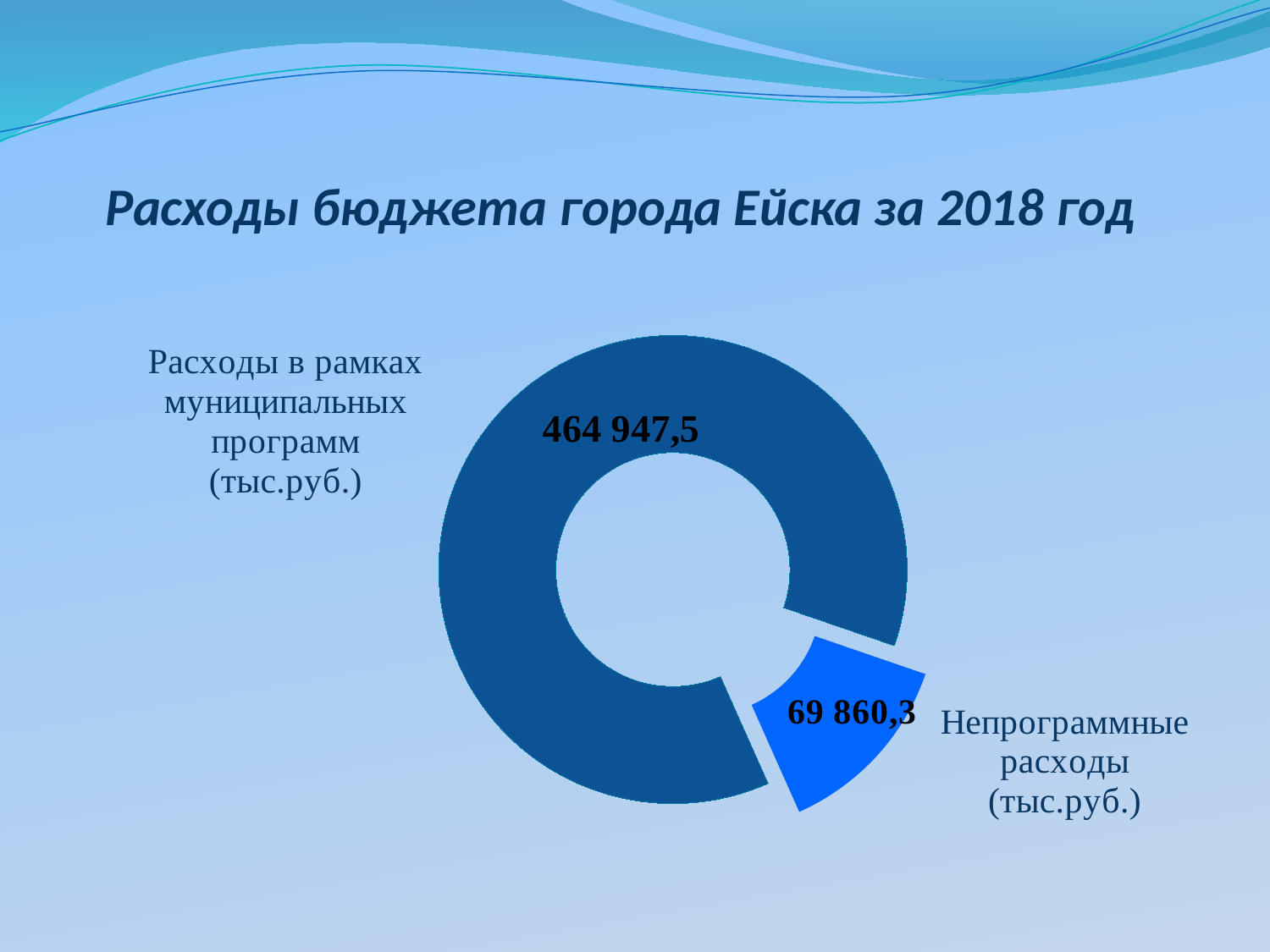
What is the difference between the value for Расходы в рамках муниципальных программ and the value for Непрограммные расходы? 395 087,2 What is the value for Расходы в рамках муниципальных программ (тыс.руб.)? 464 947,5 What is the total of the two values shown in the chart? 534 807,8 Which is larger: Расходы в рамках муниципальных программ or Непрограммные расходы? Расходы в рамках муниципальных программ What is the value for Непрограммные расходы (тыс.руб.)? 69 860,3 What kind of chart is shown on the slide? Doughnut (pie) chart What is the title of the slide? Расходы бюджета города Ейска за 2018 год Which category has the largest value? Расходы в рамках муниципальных программ How many categories does the chart show? 2 Which category has the smallest value? Непрограммные расходы